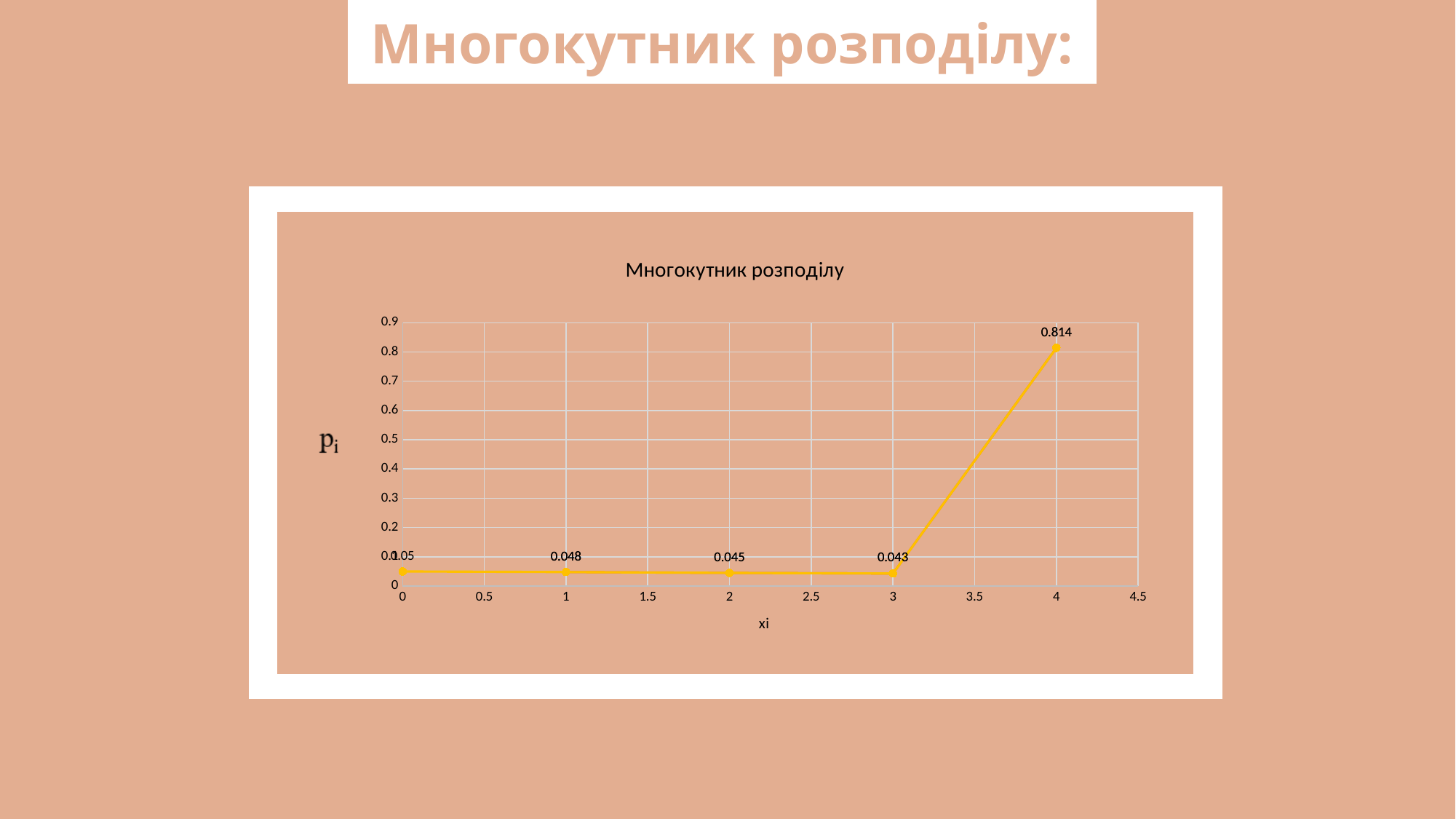
What is the value of pi at xi = 3? 0.043 What is the value of pi at xi = 1? 0.048 What is the difference between the pi values at xi = 4 and xi = 3? 0.771 How many data points are plotted on the chart? 5 What is the value of pi at xi = 0? 0.05 What is the value of pi at xi = 4? 0.814 What is the title of the chart? Многокутник розподілу What is the label of the x axis? xi At which value of xi is pi highest? 4 What type of chart is shown on the slide? line chart Which is larger, the pi value at xi = 2 or at xi = 1? xi = 1 At which value of xi is pi lowest? 3